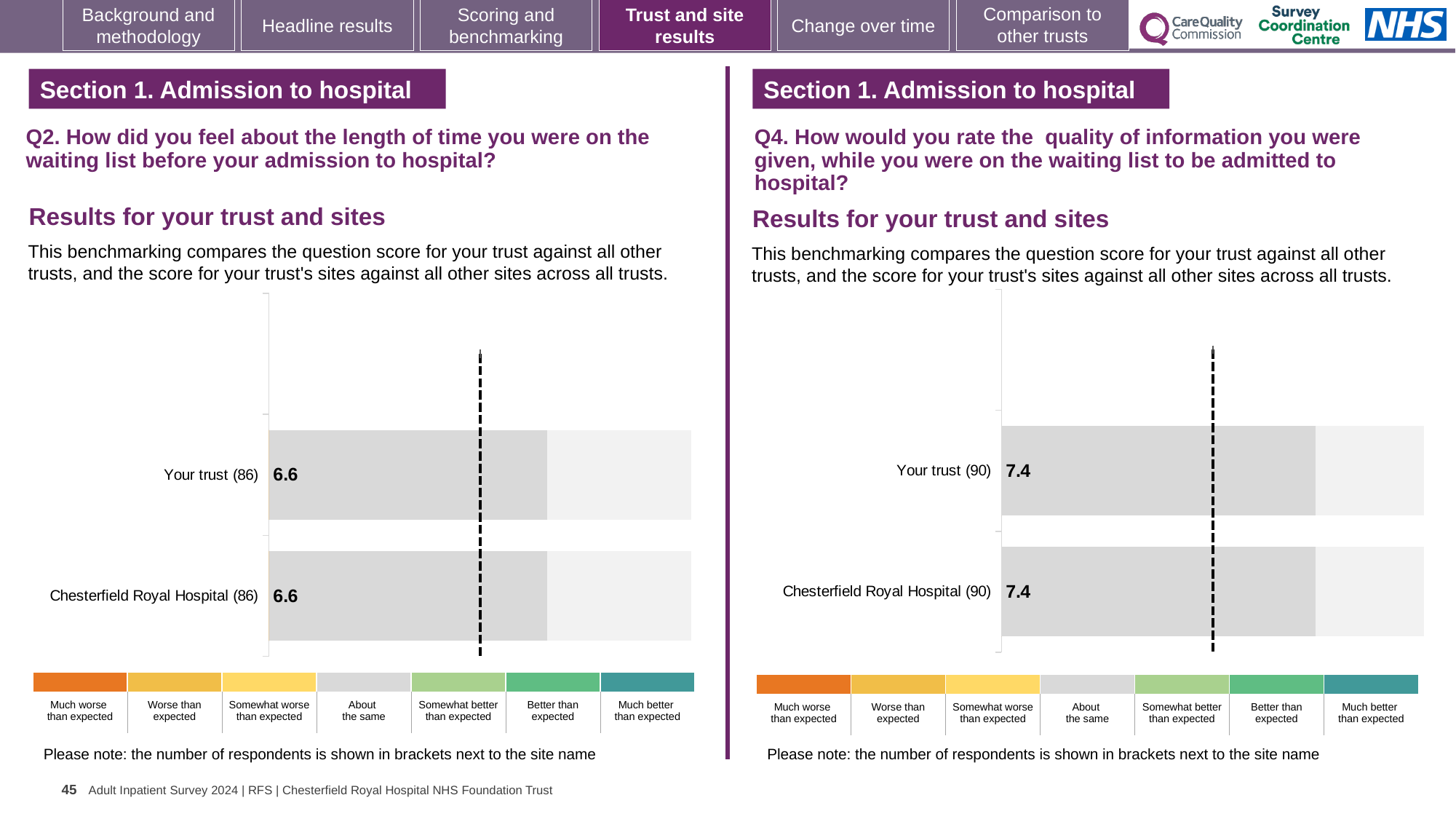
Is the score for Your trust on the Q4 chart (right) larger or smaller than the score for Your trust on the Q2 chart (left)? Larger On the Q4 chart (right), what is the difference between the score for Your trust and the score for Chesterfield Royal Hospital? 0 How many bars are plotted on the Q4 chart (right)? 2 On the Q2 chart (left), what is the score for Your trust? 6.6 What kind of chart is the Q2 chart (left)? Bar chart On the Q4 chart (right), what is the score for Your trust? 7.4 On the Q2 chart (left), what is the difference between the score for Your trust and the score for Chesterfield Royal Hospital? 0 On the Q2 chart (left), what is the score for Chesterfield Royal Hospital? 6.6 On the Q4 chart (right), what is the score for Chesterfield Royal Hospital? 7.4 On the Q2 chart (left), how many respondents are shown in brackets next to Your trust? 86 On the Q4 chart (right), how many respondents are shown in brackets next to Chesterfield Royal Hospital? 90 How many bars are plotted on the Q2 chart (left)? 2